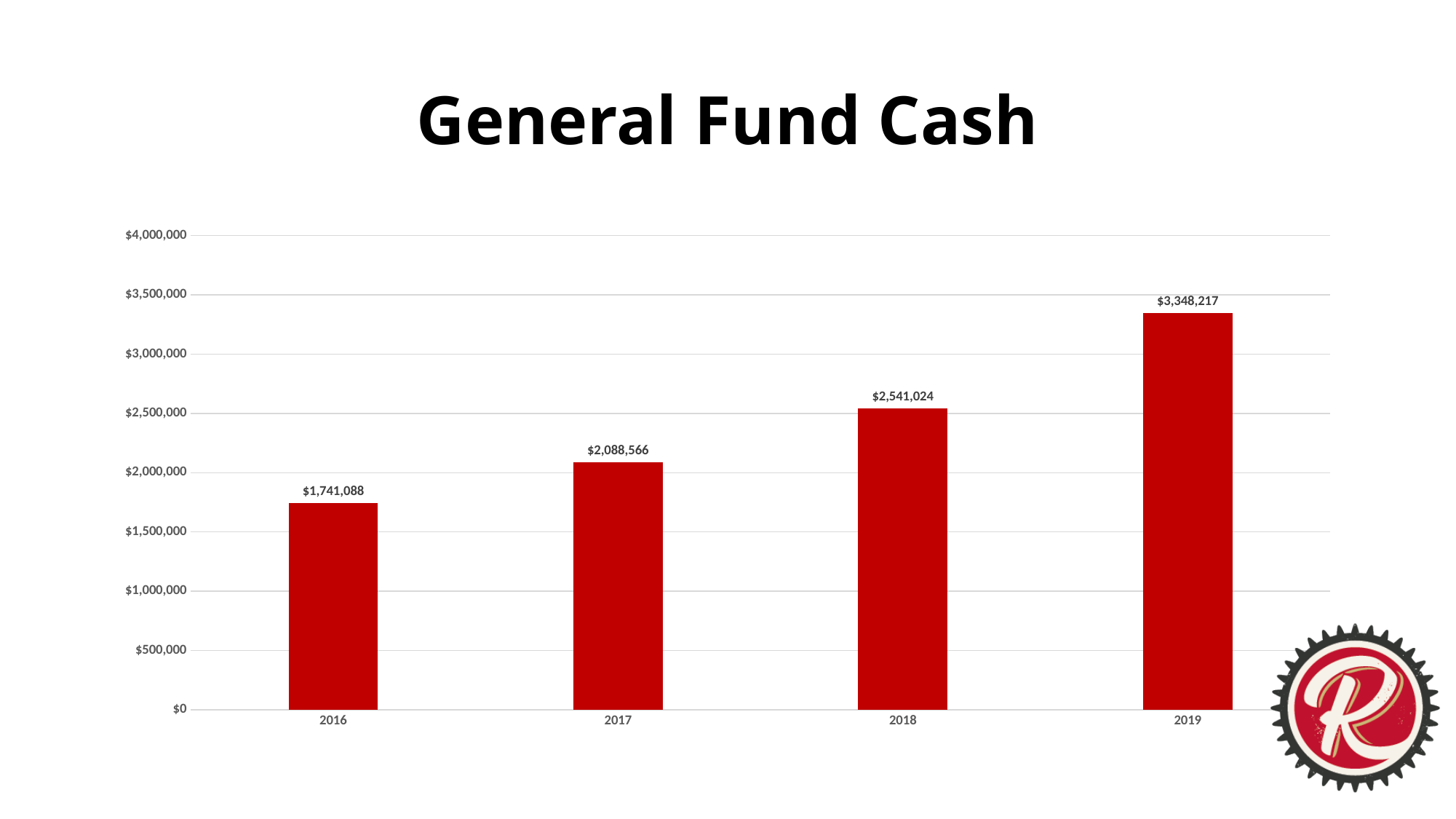
What is the General Fund Cash value for 2016? $1,741,088 What is the difference in General Fund Cash between 2019 and 2016? $1,607,129 Do the General Fund Cash values rise or fall from 2016 to 2019? rise What is the General Fund Cash value for 2018? $2,541,024 How many years are shown on the chart? 4 What is the General Fund Cash value for 2019? $3,348,217 Is the General Fund Cash value for 2017 greater or less than $2,000,000? greater Which year has the lowest General Fund Cash? 2016 What kind of chart is shown on the slide? bar chart Which year has the highest General Fund Cash? 2019 What is the difference in General Fund Cash between 2018 and 2017? $452,458 Which year has a larger General Fund Cash value, 2017 or 2018? 2018